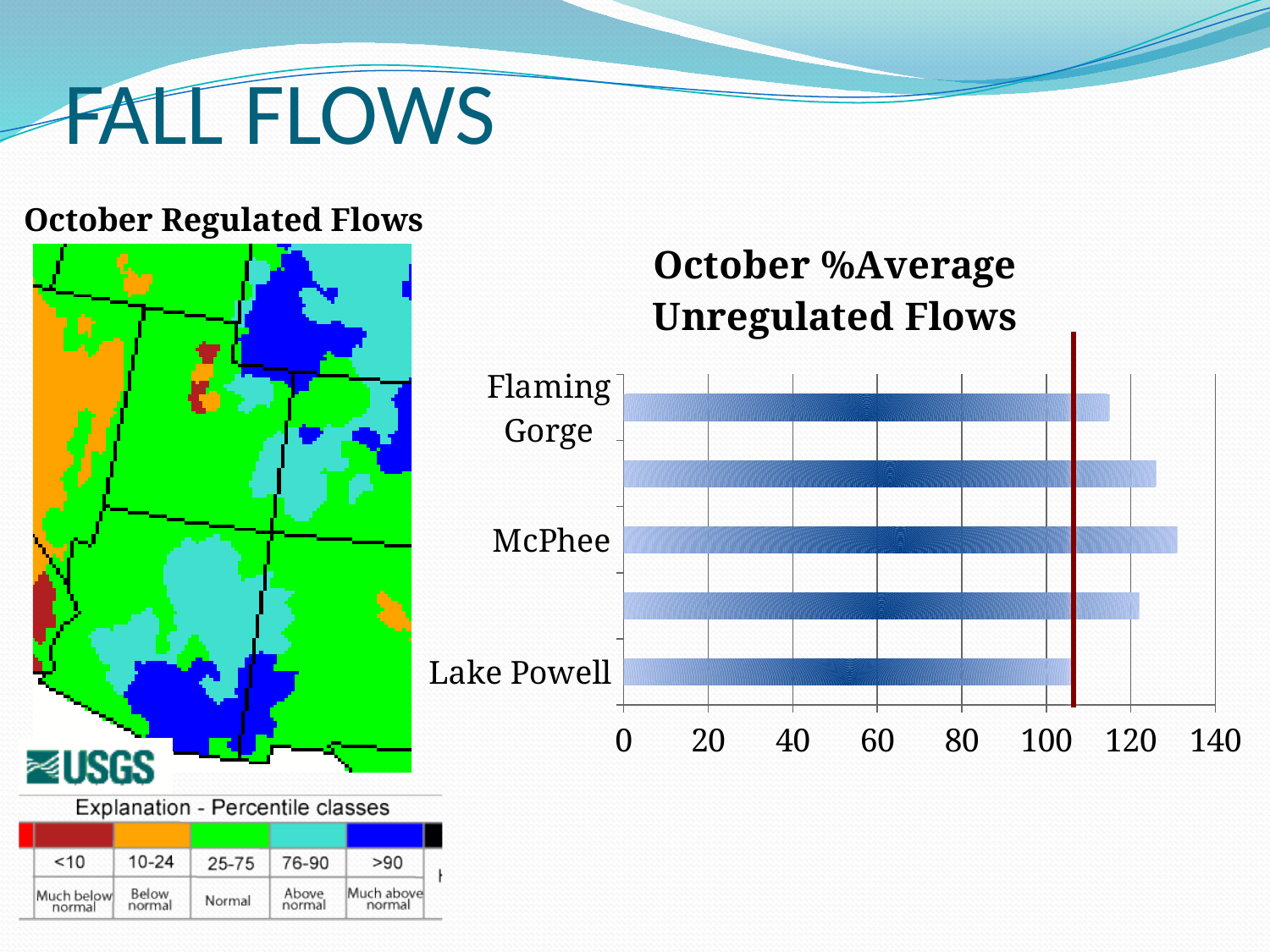
In the October %Average Unregulated Flows chart, which labeled category has the lowest value? Lake Powell In the October %Average Unregulated Flows chart, is the value for Lake Powell greater or less than 120? less What is the maximum value shown on the horizontal axis of the October %Average Unregulated Flows chart? 140 In the October %Average Unregulated Flows chart, is the value for McPhee greater or less than 120? greater In the October %Average Unregulated Flows chart, which has the larger value, Flaming Gorge or McPhee? McPhee In the October %Average Unregulated Flows chart, is the value for Flaming Gorge greater or less than 120? less What is the title of the chart on the right side of the slide? October %Average Unregulated Flows In the October %Average Unregulated Flows chart, which has the larger value, Flaming Gorge or Lake Powell? Flaming Gorge In the October %Average Unregulated Flows chart, which labeled category has the highest value? McPhee What kind of chart is shown on the right side of the slide? bar chart How many bars are plotted in the October %Average Unregulated Flows chart? 5